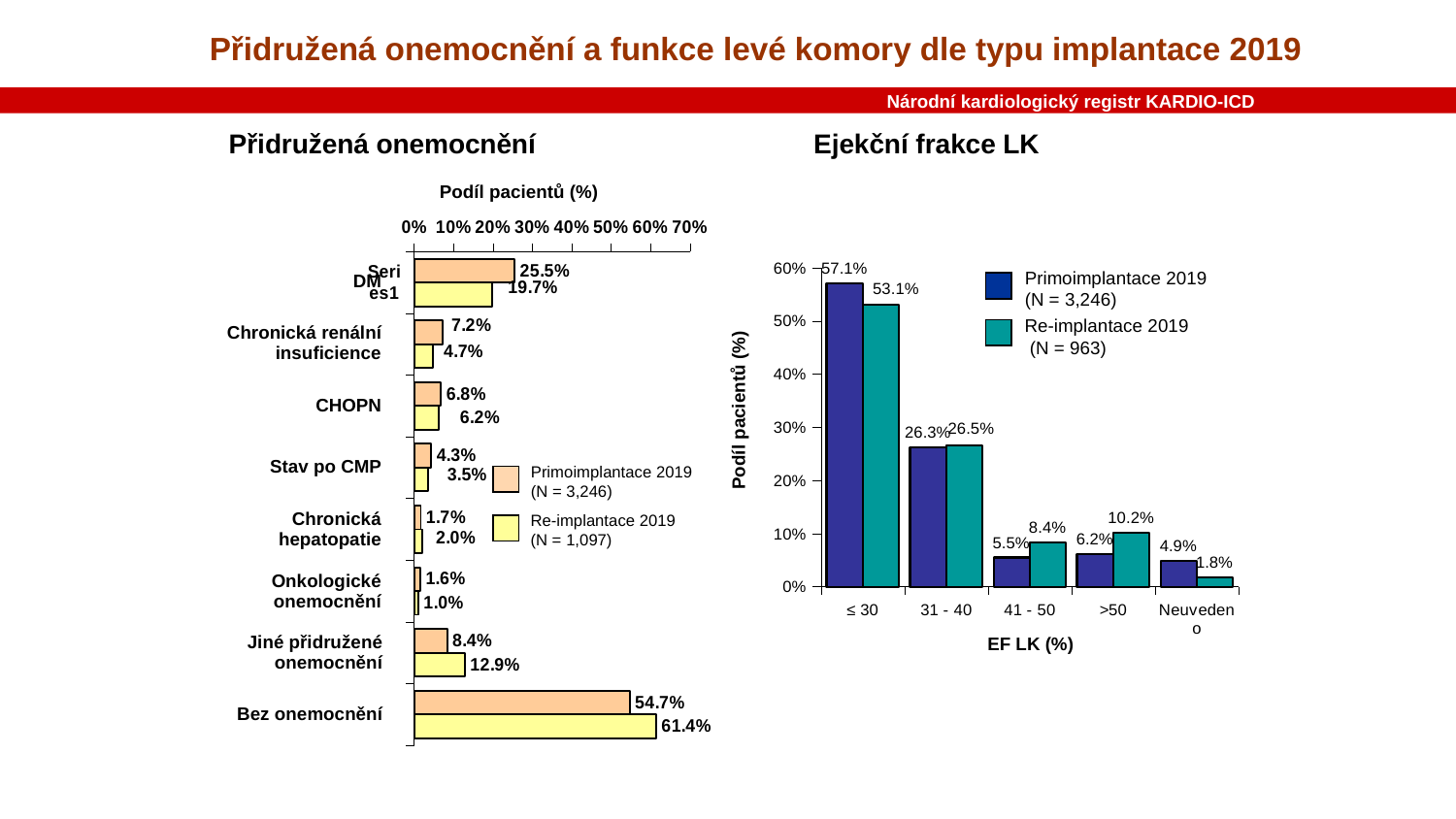
In the 'Přidružená onemocnění' chart, what is the value for Primoimplantace 2019 in the 'Bez onemocnění' category? 54.7% In the 'Ejekční frakce LK' chart, what is the difference between Primoimplantace 2019 and Re-implantace 2019 in the 'Neuvedeno' category? 3.1% In the 'Ejekční frakce LK' chart, what is the value for Re-implantace 2019 in the '>50' category? 10.2% In the 'Ejekční frakce LK' chart, which is larger for the '41 - 50' category: Primoimplantace 2019 or Re-implantace 2019? Re-implantace 2019 In the 'Ejekční frakce LK' chart, what is the value for Primoimplantace 2019 in the '≤ 30' category? 57.1% In the 'Ejekční frakce LK' chart, how many series does the legend list? 2 In the 'Přidružená onemocnění' chart, which category has the highest value for Re-implantace 2019? Bez onemocnění In the 'Přidružená onemocnění' chart, how many categories are shown on the vertical axis? 8 In the 'Přidružená onemocnění' chart, what is the value for Re-implantace 2019 in the 'Jiné přidružené onemocnění' category? 12.9% What kind of chart is the 'Ejekční frakce LK' chart? Bar chart In the 'Přidružená onemocnění' chart, which category has the lowest value for Primoimplantace 2019? Onkologické onemocnění In the 'Přidružená onemocnění' chart, what is the difference between the Primoimplantace 2019 and Re-implantace 2019 values for DM? 5.8%